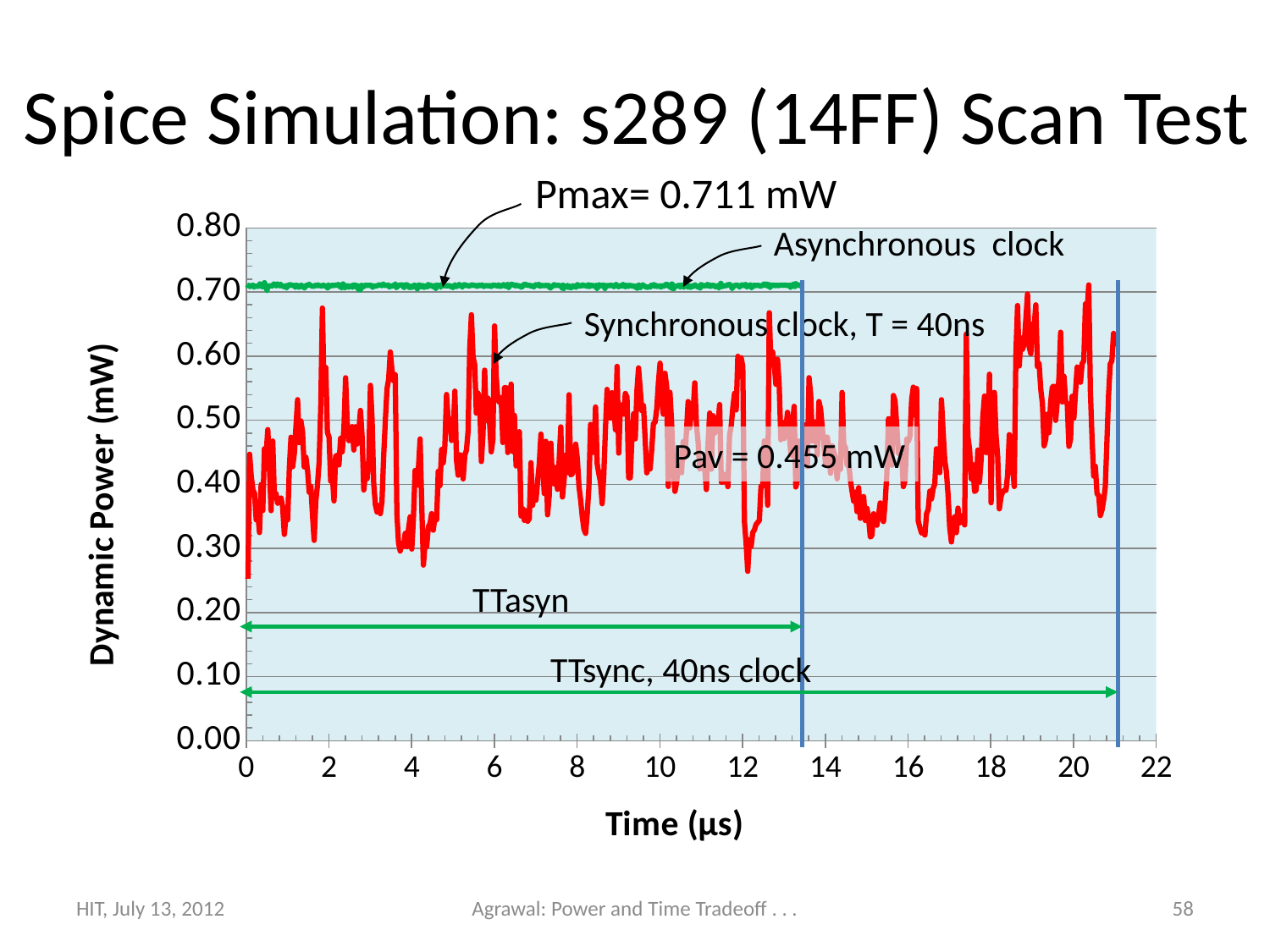
What kind of chart is shown on the slide? Line chart What is the value of Pav annotated on the chart? 0.455 mW Which test takes longer to complete, TTasyn or TTsync? TTsync What is the difference between Pmax and Pav as annotated on the chart? 0.256 mW How many data series are plotted on the chart? 2 What is the value of Pmax annotated on the chart? 0.711 mW What clock period is given for the synchronous clock in the chart annotation? T = 40ns What is the label of the y-axis? Dynamic Power (mW) Is the dynamic power of the asynchronous clock greater or less than 0.80 mW? less Does the asynchronous clock power rise, fall, or stay flat over time? Stays flat Is the dynamic power of the asynchronous clock greater or less than 0.60 mW? greater Which series has the higher dynamic power throughout the test, the asynchronous clock or the synchronous clock? Asynchronous clock